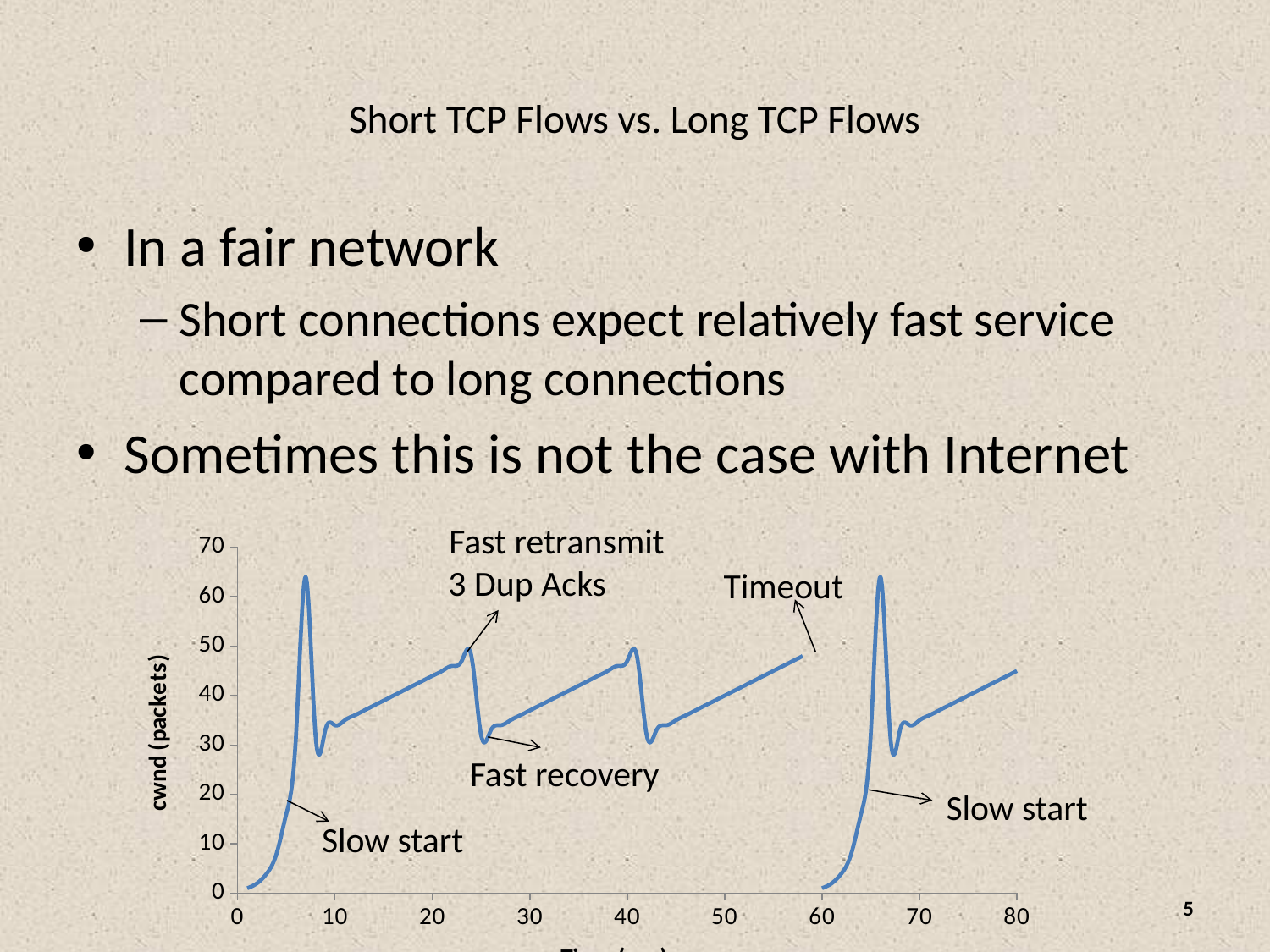
Is the value of cwnd at time 80 greater or less than 40? greater Is the value of cwnd at time 60 greater or less than 10? less Between time 10 and time 20, does the cwnd value rise or fall? rise What is the highest value shown on the y axis of the chart? 70 What is the label of the y axis of the chart? cwnd (packets) Is the value of cwnd at time 20 greater or less than 30? greater Between time 70 and time 80, does the cwnd value rise or fall? rise Which event is annotated on the chart at the point where the line drops to zero near time 60? Timeout What kind of chart is shown on the slide? line chart